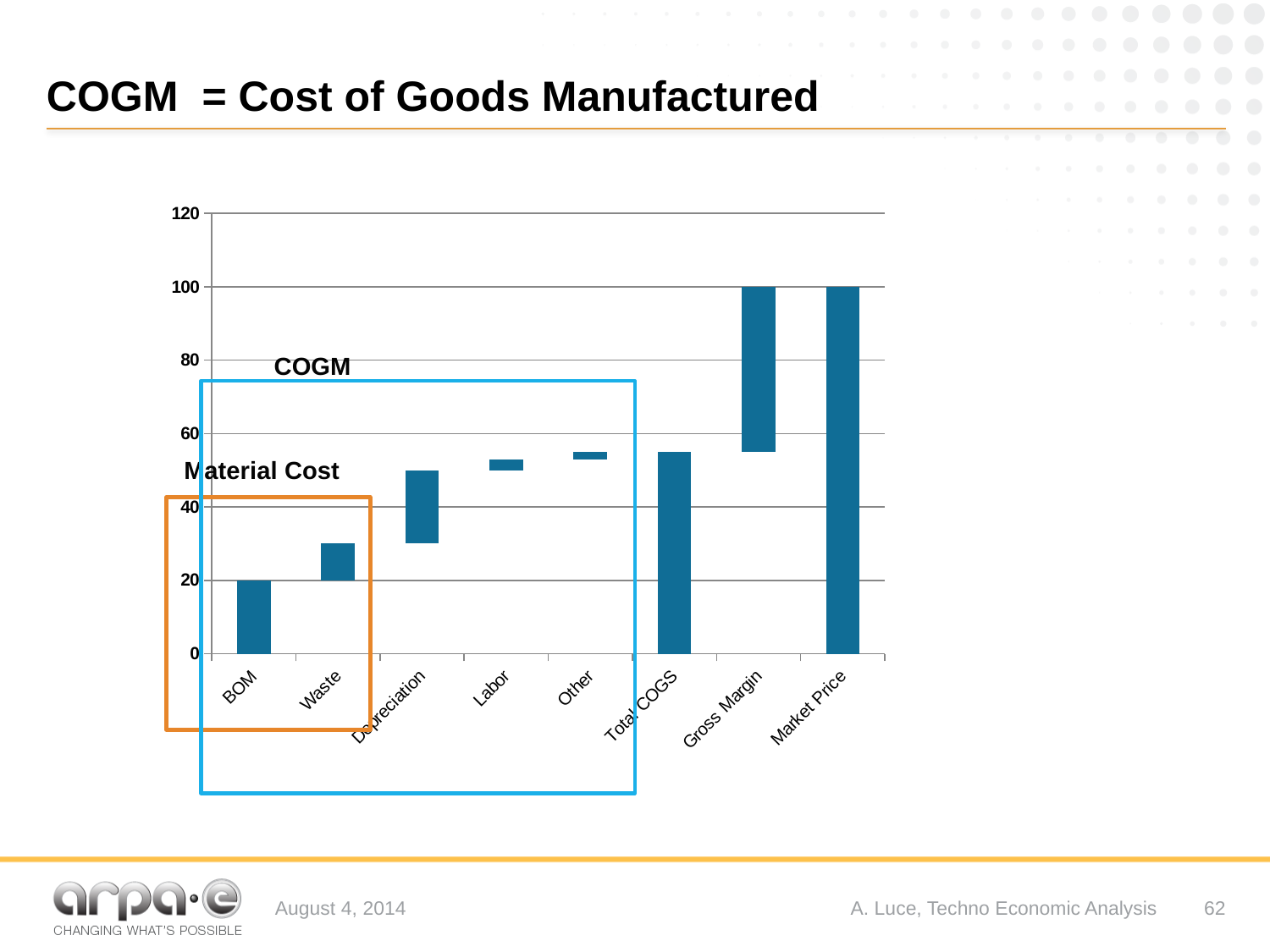
What value does the Market Price bar reach on the y axis? 100 How many categories are shown on the x axis of the chart? 8 Which is larger, the value for Total COGS or the value for Market Price? Market Price Is the value for Total COGS greater or less than 60? less Is the top of the Depreciation bar greater or less than 40? greater Which category has the tallest bar measured from the zero baseline? Market Price Which bar is taller, BOM or Waste? BOM Is the value for Total COGS greater or less than 40? greater What kind of chart is shown on the slide? bar chart What value does the top of the BOM bar reach on the y axis? 20 What is the title of the slide containing the chart? COGM = Cost of Goods Manufactured Which two categories are enclosed by the orange box labelled Material Cost? BOM and Waste